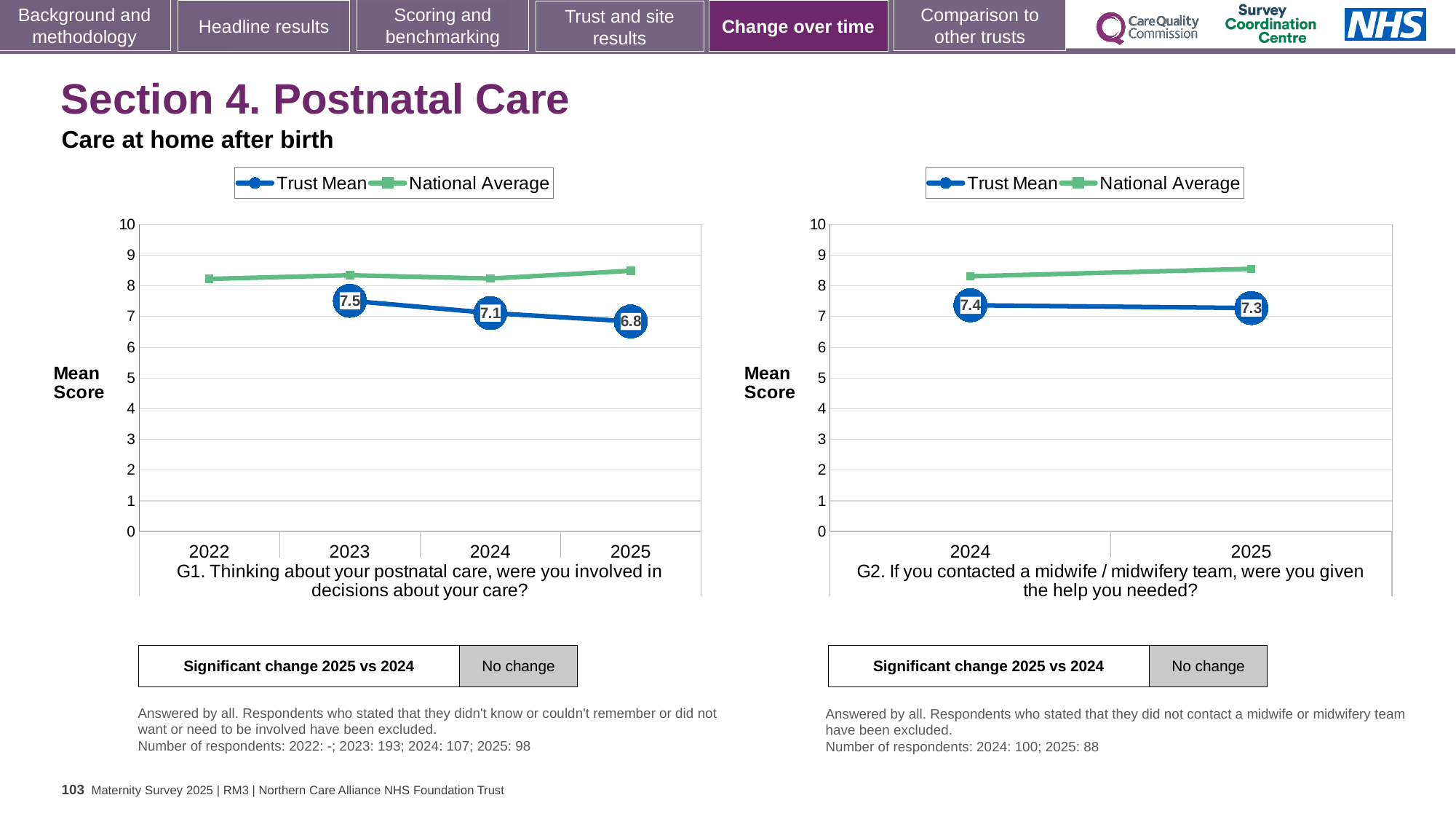
In the G2 chart on the right, which is higher in 2025, the Trust Mean or the National Average? National Average In the G1 chart on the left, what is the Trust Mean for 2025? 6.8 In the G1 chart on the left, is the National Average for 2025 greater or less than 8? greater What kind of chart is the G2 chart on the right? line chart How many years are shown on the x axis of the G1 chart on the left? 4 In the G1 chart on the left, what is the Trust Mean for 2023? 7.5 In the G2 chart on the right, what is the Trust Mean for 2025? 7.3 In the G1 chart on the left, does the Trust Mean rise or fall from 2023 to 2025? fall In the G1 chart on the left, by how much did the Trust Mean fall from 2023 to 2025? 0.7 How many series does the legend of the G2 chart on the right list? 2 In the G2 chart on the right, what is the Trust Mean for 2024? 7.4 In the G1 chart on the left, which year has the lowest Trust Mean? 2025